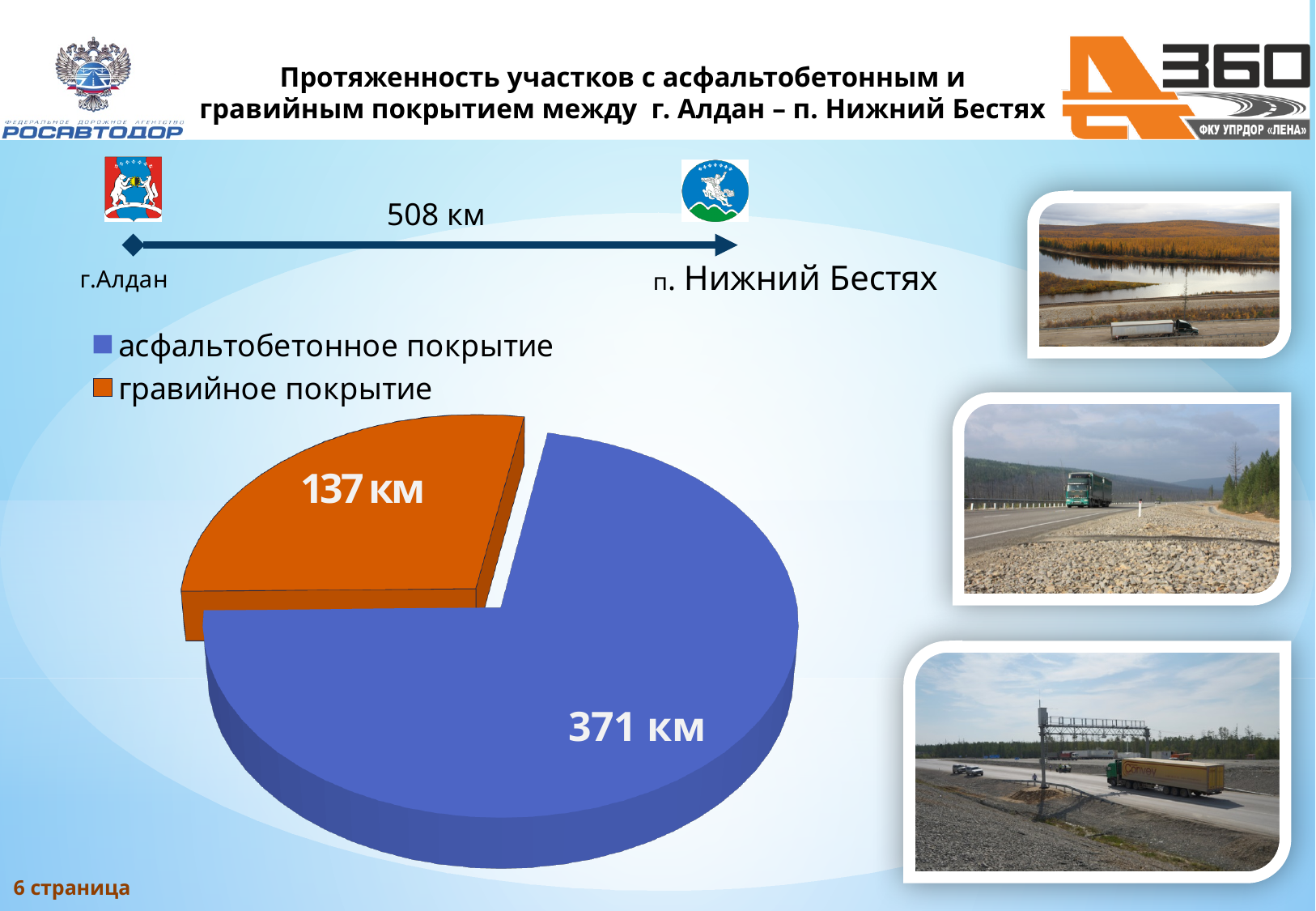
By how many kilometres does the asphalt-concrete section exceed the gravel section? 234 км Is the asphalt-concrete section longer or shorter than the gravel section? longer What is the length of the gravel surface (гравийное покрытие) section shown in the pie chart? 137 км What is the length of the asphalt-concrete surface (асфальтобетонное покрытие) section shown in the pie chart? 371 км Which surface type has the smaller slice in the pie chart? гравийное покрытие How many slices does the pie chart have? 2 Which surface type has the larger slice in the pie chart? асфальтобетонное покрытие What is the combined length of the asphalt-concrete and gravel sections in the pie chart? 508 км How many entries does the chart legend list? 2 What colour is the slice for гравийное покрытие in the pie chart? orange What type of chart is shown on the slide? pie chart